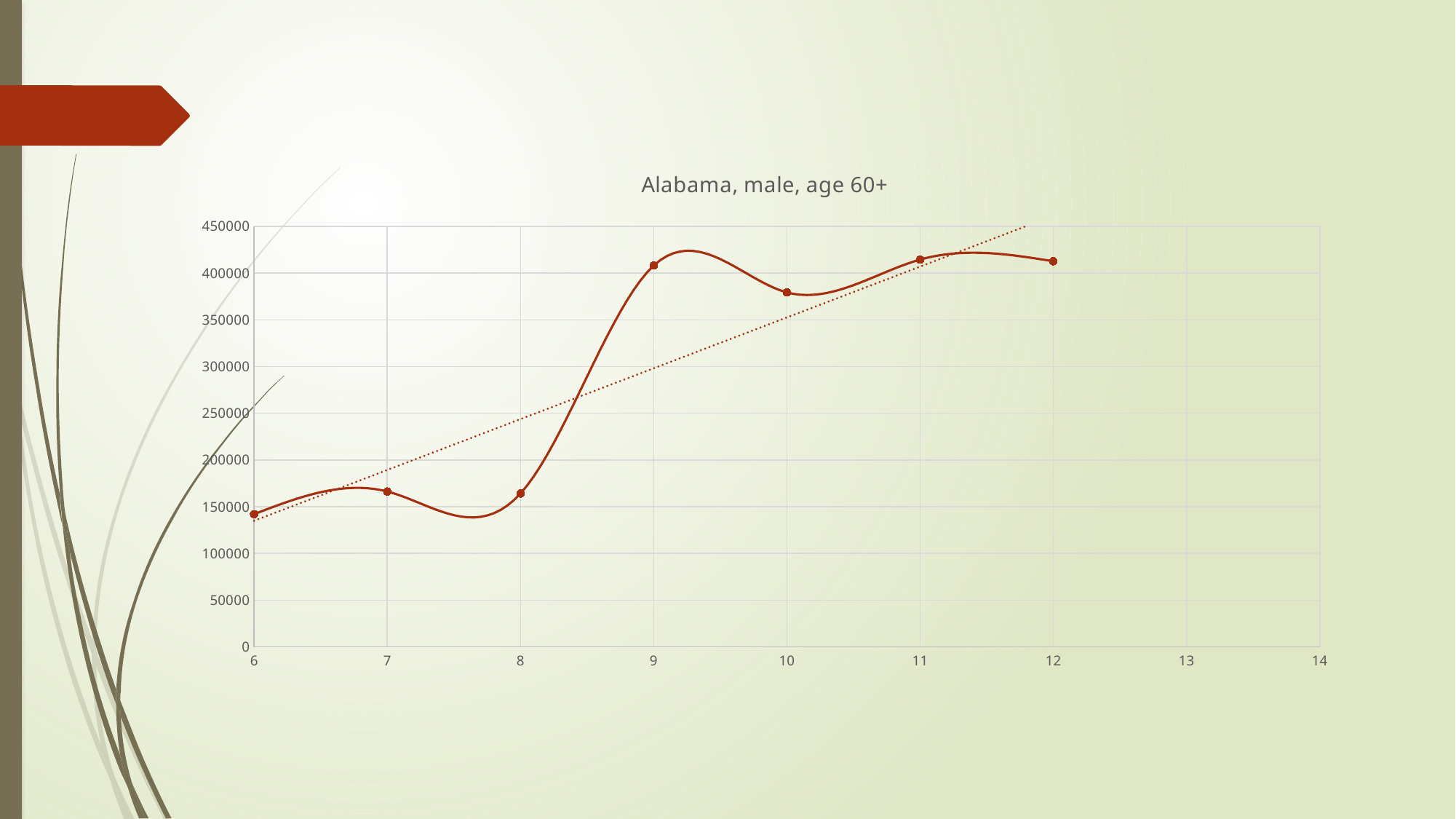
How many data points are plotted on the chart? 7 Which is larger, the value at x = 8 or the value at x = 9? x = 9 Is the value at x = 8 greater or less than 200000? less What is the title of the chart? Alabama, male, age 60+ Which is larger, the value at x = 9 or the value at x = 10? x = 9 Is the value at x = 6 greater or less than 150000? less Is the value at x = 10 greater or less than 350000? greater At which x value is the plotted value lowest? 6 What kind of chart is shown on the slide? line chart Do the values generally rise or fall as x increases from 6 to 12? rise